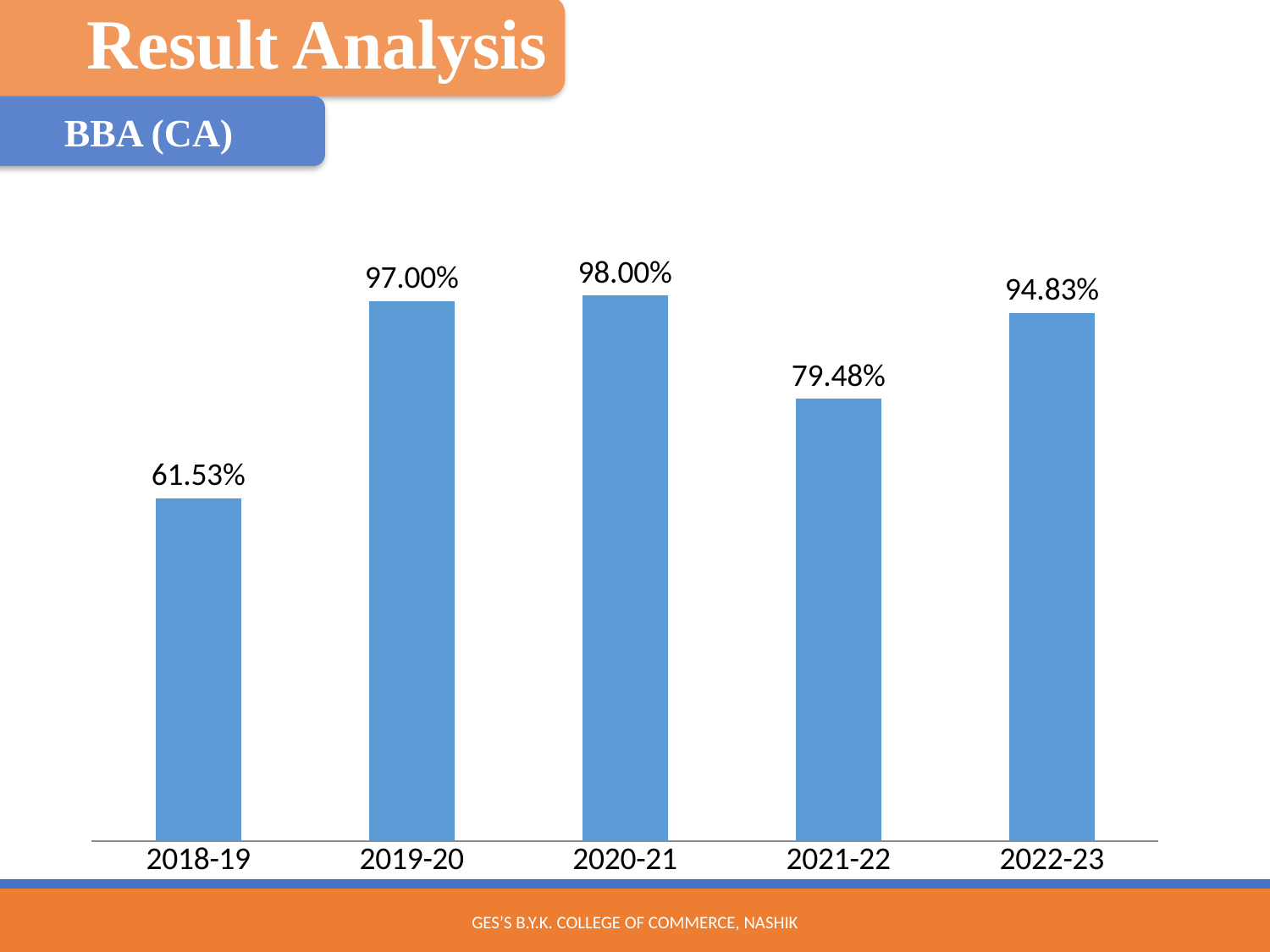
How many years are shown on the x axis? 5 What is the value for 2018-19? 61.53% What is the value for 2021-22? 79.48% Which programme does the chart on the slide refer to? BBA (CA) What is the difference between the values for 2022-23 and 2021-22? 15.35% What is the value for 2022-23? 94.83% Does the value rise or fall from 2018-19 to 2019-20? Rise What kind of chart is shown on the slide? Bar chart Which year has the lowest value? 2018-19 Which is larger, the value for 2019-20 or the value for 2021-22? 2019-20 What is the difference between the values for 2020-21 and 2018-19? 36.47% Which year has the highest value? 2020-21